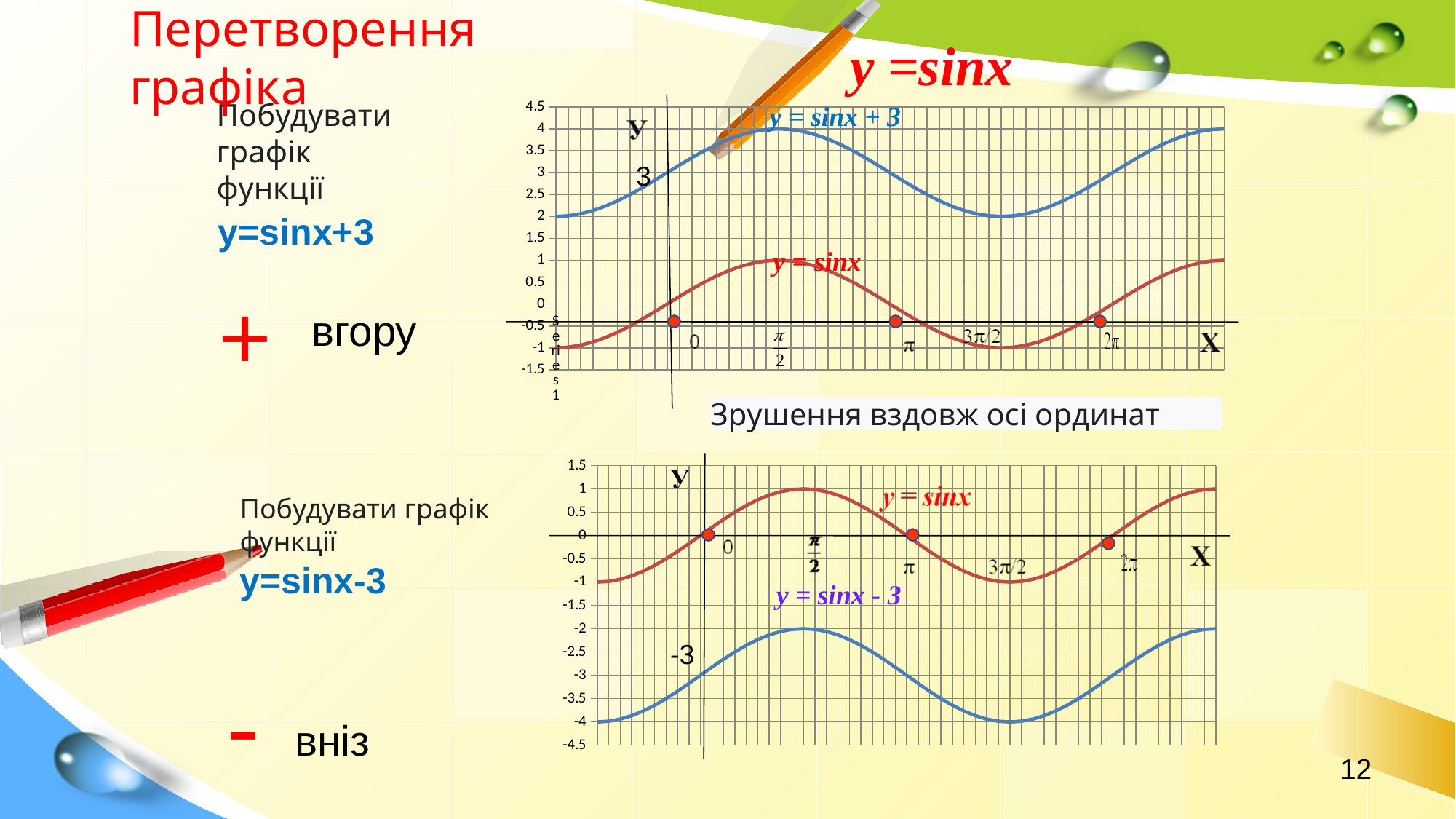
In the bottom chart, what is the lowest tick label on the y axis? -4.5 In the top chart, what is the maximum value reached by the curve y = sinx + 3? 4 In the top chart, which curve lies higher, y = sinx + 3 or y = sinx? y = sinx + 3 In the bottom chart, is the value of y = sinx - 3 at x = π/2 greater or less than 0? less What kind of chart is the top chart on the slide? line chart In the bottom chart, what is the maximum value reached by the curve y = sinx - 3? -2 In the top chart, what is the difference between the maximum of y = sinx + 3 and the maximum of y = sinx? 3 In the bottom chart, what colour is the curve y = sinx? red In the bottom chart, what is the minimum value reached by the curve y = sinx - 3? -4 In the top chart, what is the minimum value reached by the curve y = sinx + 3? 2 In the top chart, how many curves are plotted? 2 In the top chart, does the curve y = sinx rise or fall between x = 0 and x = π/2? rise